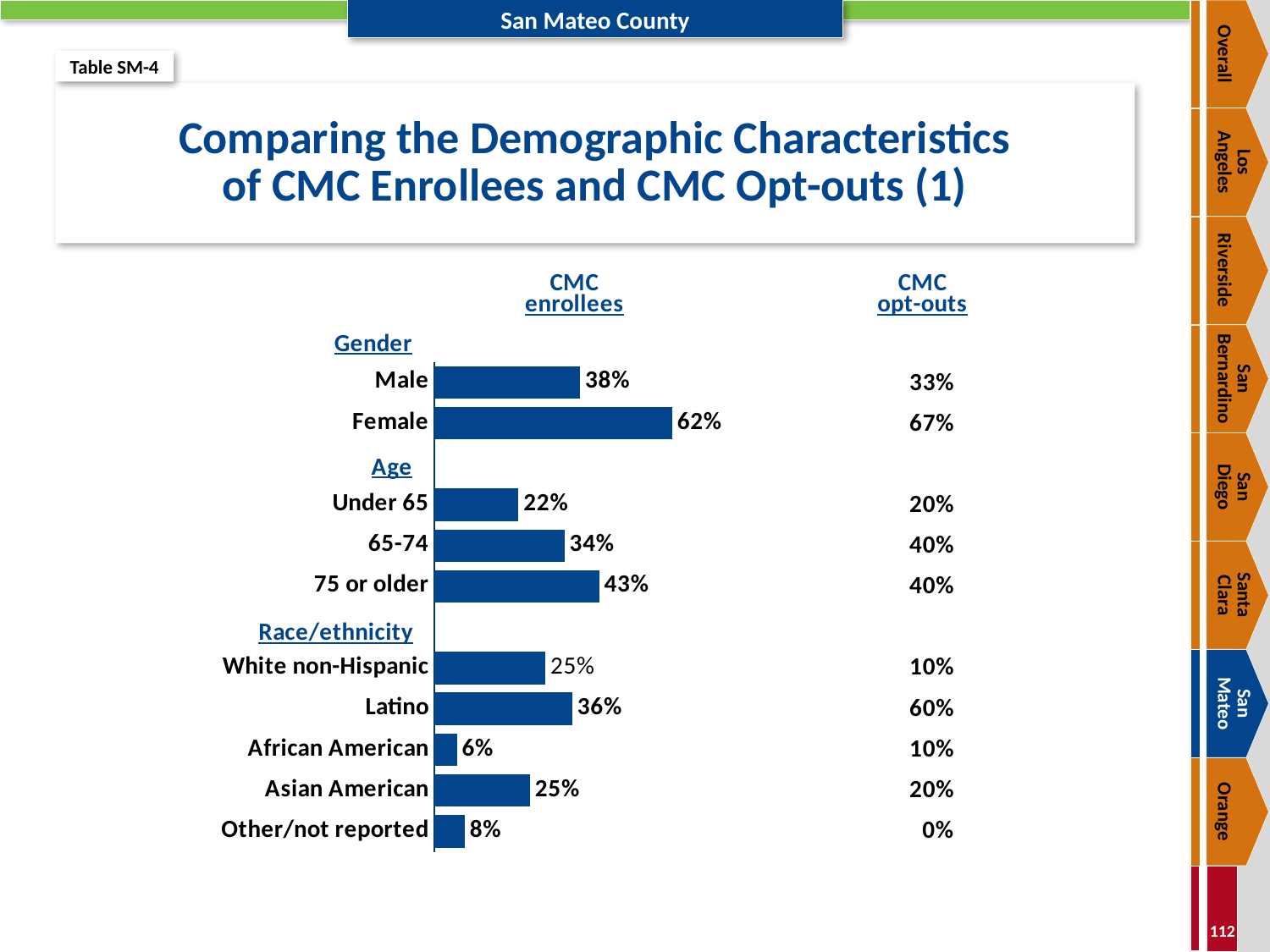
How many bars are plotted in the CMC enrollees chart? 10 What percentage of CMC enrollees are Female? 62% Which is larger: the percentage of CMC enrollees aged 65-74 or the percentage of CMC opt-outs aged 65-74? CMC opt-outs What is the title of the slide's chart? Comparing the Demographic Characteristics of CMC Enrollees and CMC Opt-outs (1) What is the difference between the Latino percentage of CMC opt-outs and the Latino percentage of CMC enrollees? 24% What is the difference between the Female and Male percentages of CMC enrollees? 24% Among the age categories, which has the highest percentage of CMC enrollees? 75 or older What percentage of CMC enrollees are Latino? 36% What type of chart is used to show the CMC enrollees percentages? Bar chart What percentage of CMC enrollees are aged 75 or older? 43% What percentage of CMC opt-outs are Latino? 60% Among the race/ethnicity categories, which has the lowest percentage of CMC enrollees? African American